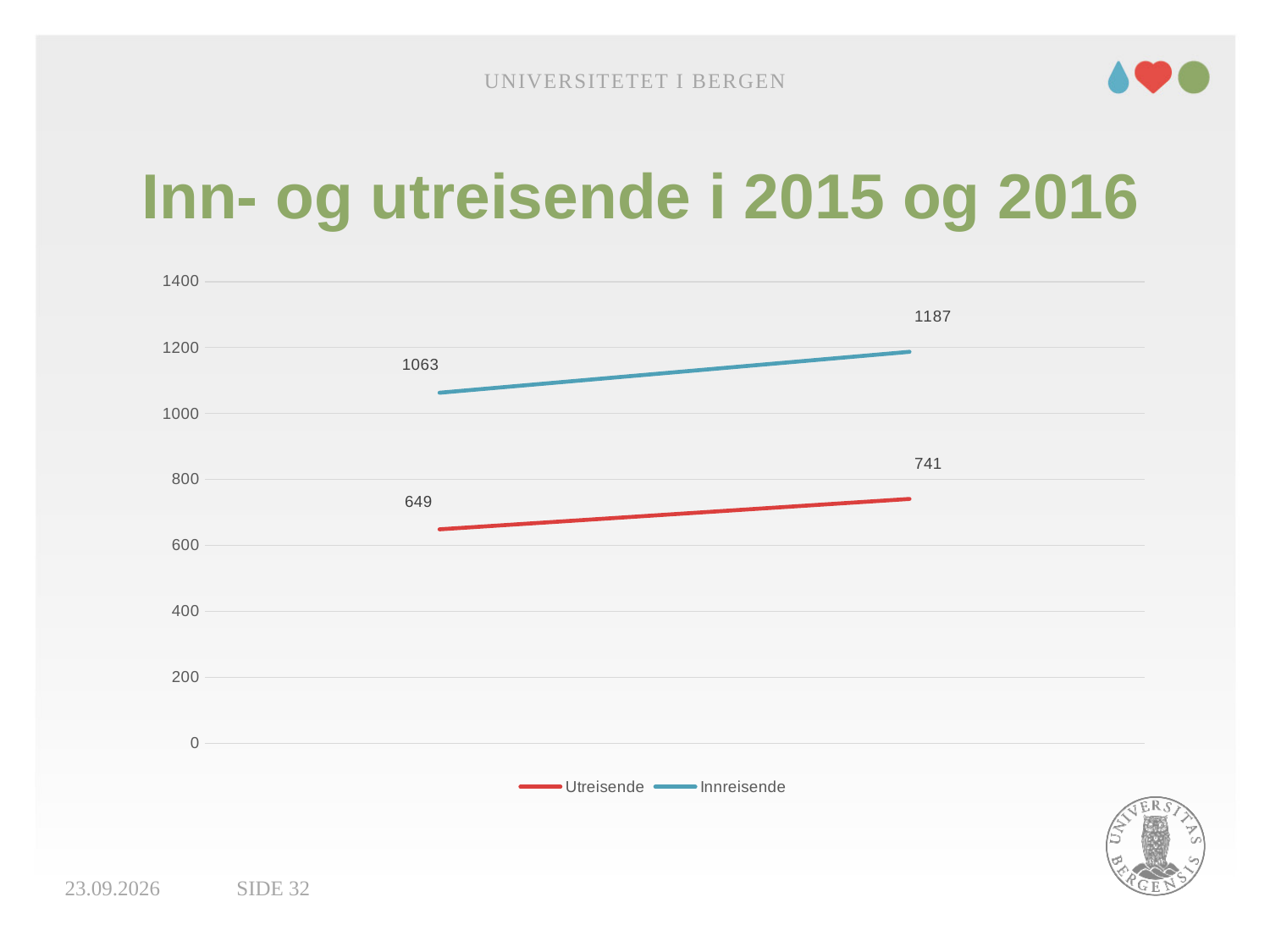
By how much does the Utreisende series increase from its first point to its second point? 92 What colour is the Utreisende line? Red Which series has the higher values, Utreisende or Innreisende? Innreisende How many series does the legend list? 2 What is the value of the Innreisende series at its left-hand (earlier) point? 1063 Does the Utreisende series rise or fall from left to right? Rise What is the value of the Innreisende series at its right-hand (later) point? 1187 What kind of chart is shown on the slide? Line chart At the right-hand point, what is the difference between the Innreisende and Utreisende values? 446 What is the value of the Utreisende series at its right-hand (later) point? 741 What is the value of the Utreisende series at its left-hand (earlier) point? 649 By how much does the Innreisende series increase from its first point to its second point? 124